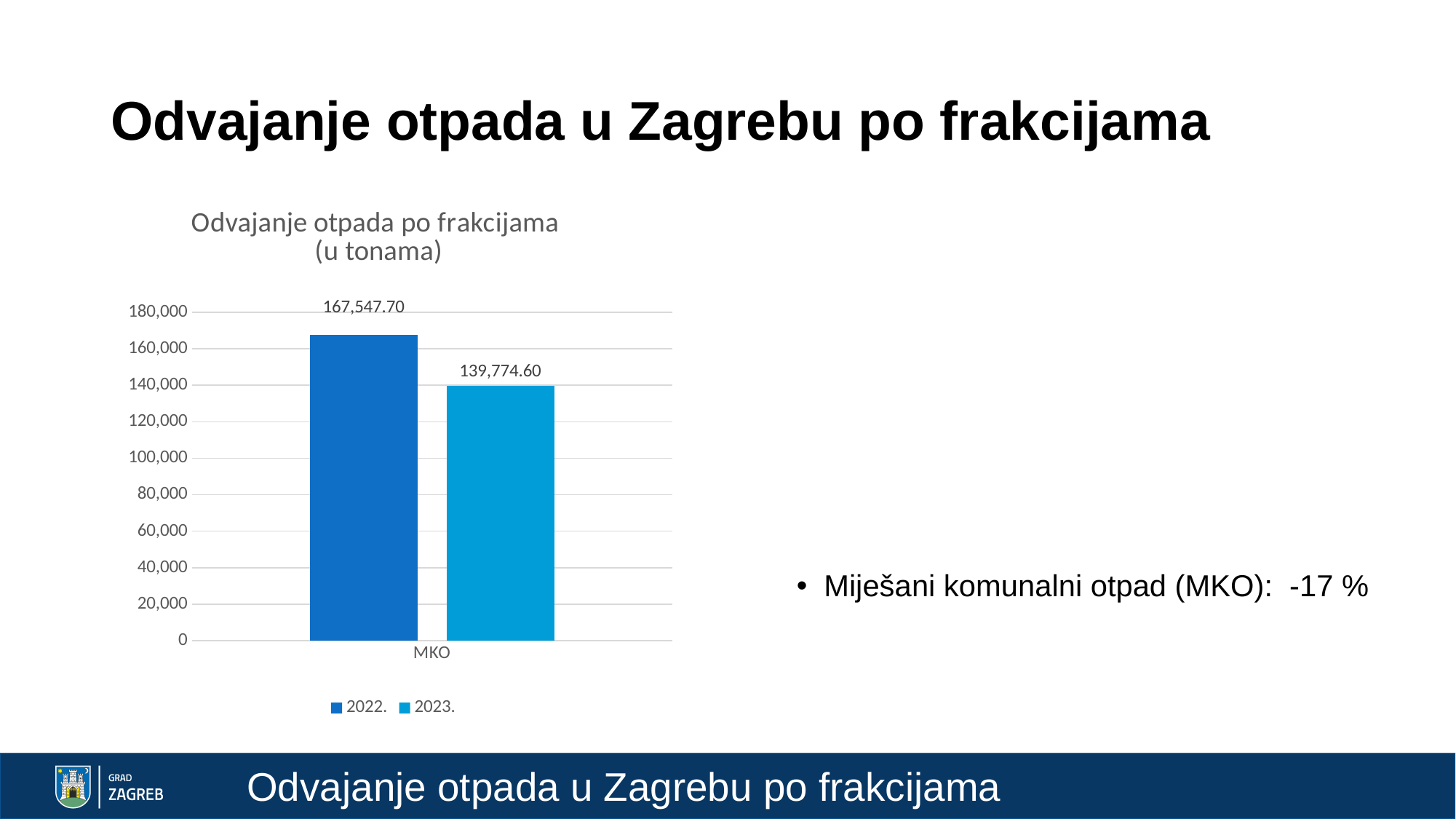
What is the title of the chart? Odvajanje otpada po frakcijama (u tonama) What is the label of the category on the x axis? MKO What kind of chart is shown on the slide? bar chart Is the value for MKO in 2022. greater or less than 160,000? greater Which series has the higher value for MKO, 2022. or 2023.? 2022. Which series has the lowest value for MKO? 2023. How many series does the legend list? 2 Is the value for MKO in 2023. greater or less than 140,000? less What is the difference between the 2022. and 2023. values for MKO? 27,773.10 How many categories are shown on the x axis? 1 What is the value for MKO in 2022.? 167,547.70 What is the value for MKO in 2023.? 139,774.60